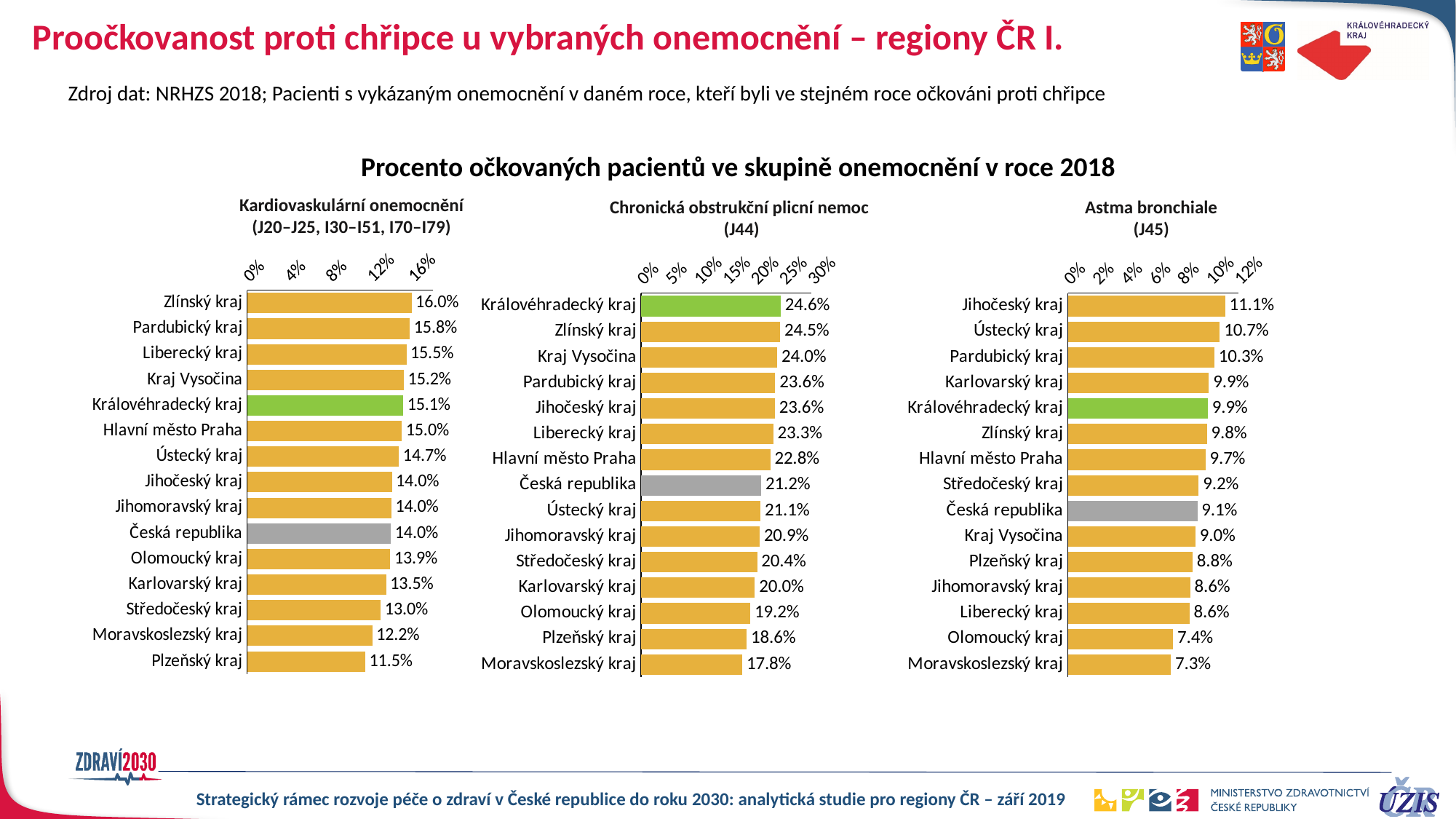
In the Chronická obstrukční plicní nemoc (J44) chart, which region has the highest value? Královéhradecký kraj In the Kardiovaskulární onemocnění chart, which region has the lowest value? Plzeňský kraj In the Astma bronchiale (J45) chart, which region has the lowest value? Moravskoslezský kraj In the Kardiovaskulární onemocnění chart, which region has the highest value? Zlínský kraj In the Astma bronchiale (J45) chart, which is larger, the value for Plzeňský kraj or Olomoucký kraj? Plzeňský kraj How many bars are shown in the Kardiovaskulární onemocnění chart? 15 What type of chart is the Astma bronchiale (J45) chart? Bar chart In the Chronická obstrukční plicní nemoc (J44) chart, which bar is coloured green? Královéhradecký kraj In the Chronická obstrukční plicní nemoc (J44) chart, what is the value for Česká republika? 21.2% In the Chronická obstrukční plicní nemoc (J44) chart, what is the difference between Královéhradecký kraj and Moravskoslezský kraj? 6.8% In the Kardiovaskulární onemocnění chart, what is the value for Královéhradecký kraj? 15.1% In the Astma bronchiale (J45) chart, what is the value for Jihočeský kraj? 11.1%